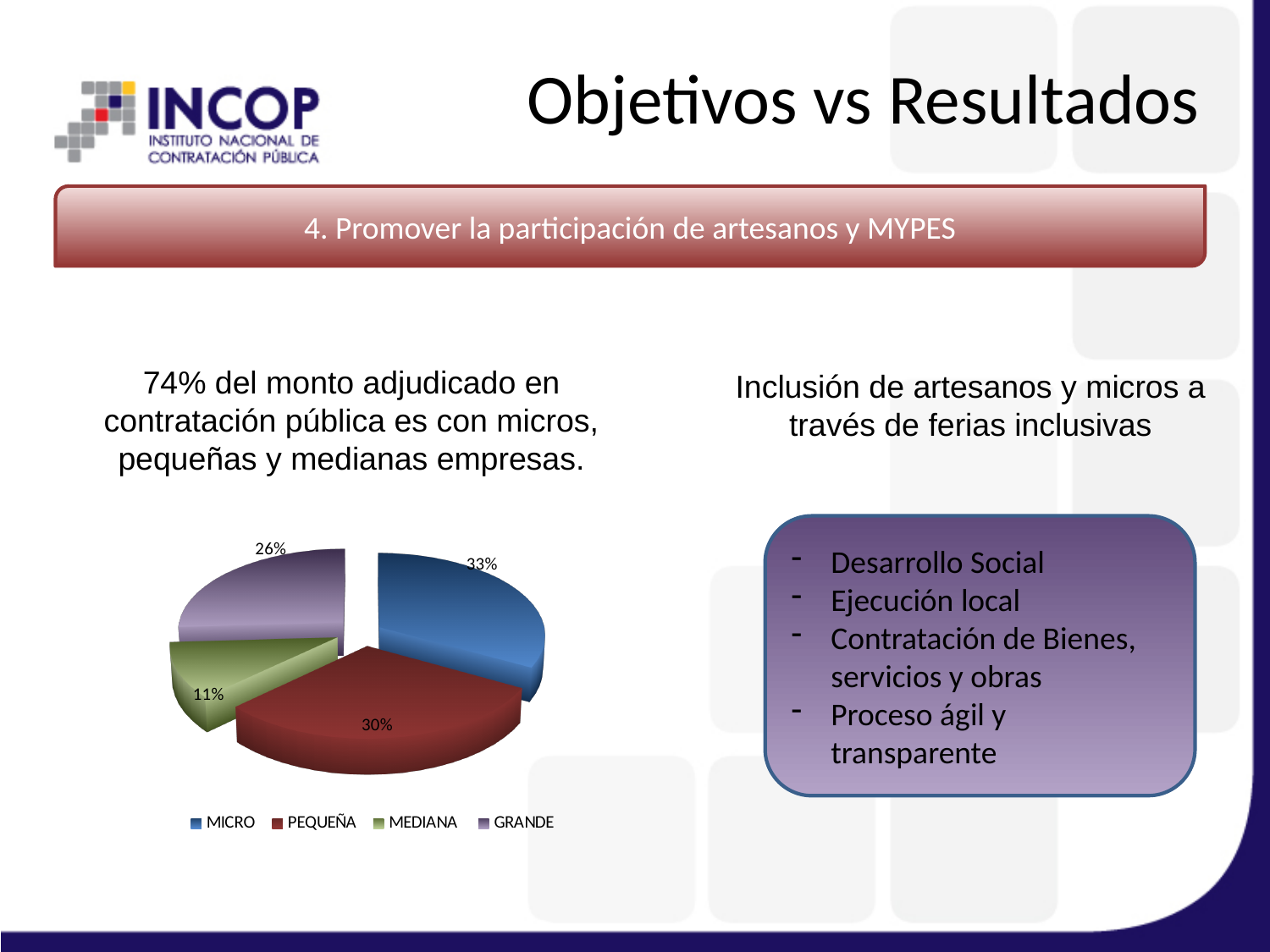
What share of the pie does MICRO represent? 33% What colour is the MICRO slice in the pie chart? blue Which category has the smallest slice of the pie? MEDIANA How many slices does the pie chart have? 4 Which category has the largest slice of the pie? MICRO What kind of chart is shown on the slide? pie chart How many entries does the legend list? 4 What is the difference in percentage points between the GRANDE slice and the MEDIANA slice? 15 Which slice is larger, PEQUEÑA or GRANDE? PEQUEÑA What share of the pie does PEQUEÑA represent? 30% What share of the pie does GRANDE represent? 26% What share of the pie does MEDIANA represent? 11%